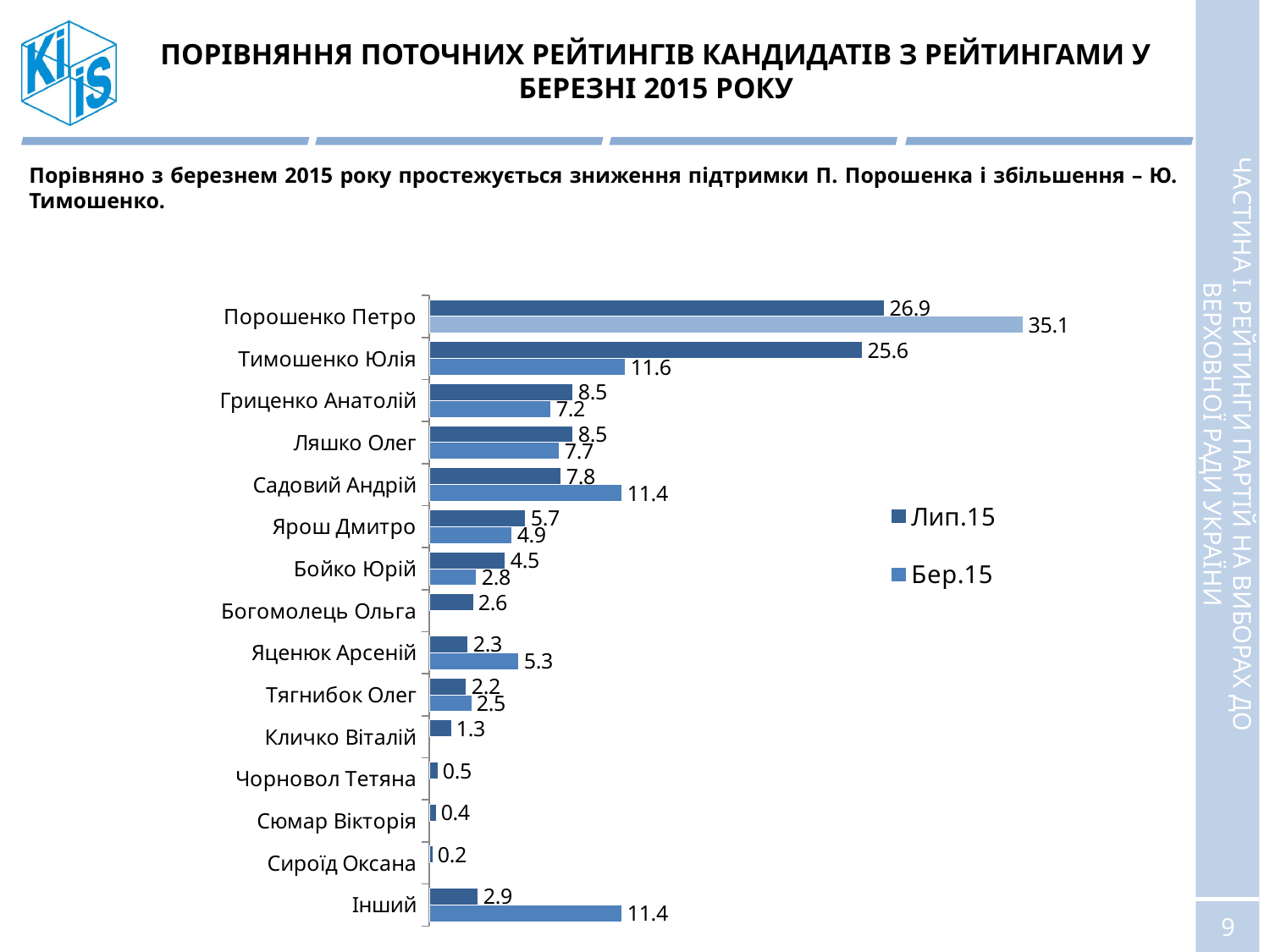
What is the Бер.15 value for Садовий Андрій? 11.4 Which is larger for Яценюк Арсеній: the Лип.15 value or the Бер.15 value? Бер.15 What is the difference between the Бер.15 and Лип.15 values for Порошенко Петро? 8.2 What kind of chart is shown on the slide? Bar chart What is the Бер.15 value for Порошенко Петро? 35.1 What is the difference between the Лип.15 and Бер.15 values for Тимошенко Юлія? 14 Which candidate has the highest Лип.15 value? Порошенко Петро Which category has the lowest Лип.15 value? Сироїд Оксана Which series is shown in the darker blue colour? Лип.15 How many candidate categories are shown on the chart? 15 How many series does the legend list? 2 What is the Лип.15 value for Тимошенко Юлія? 25.6